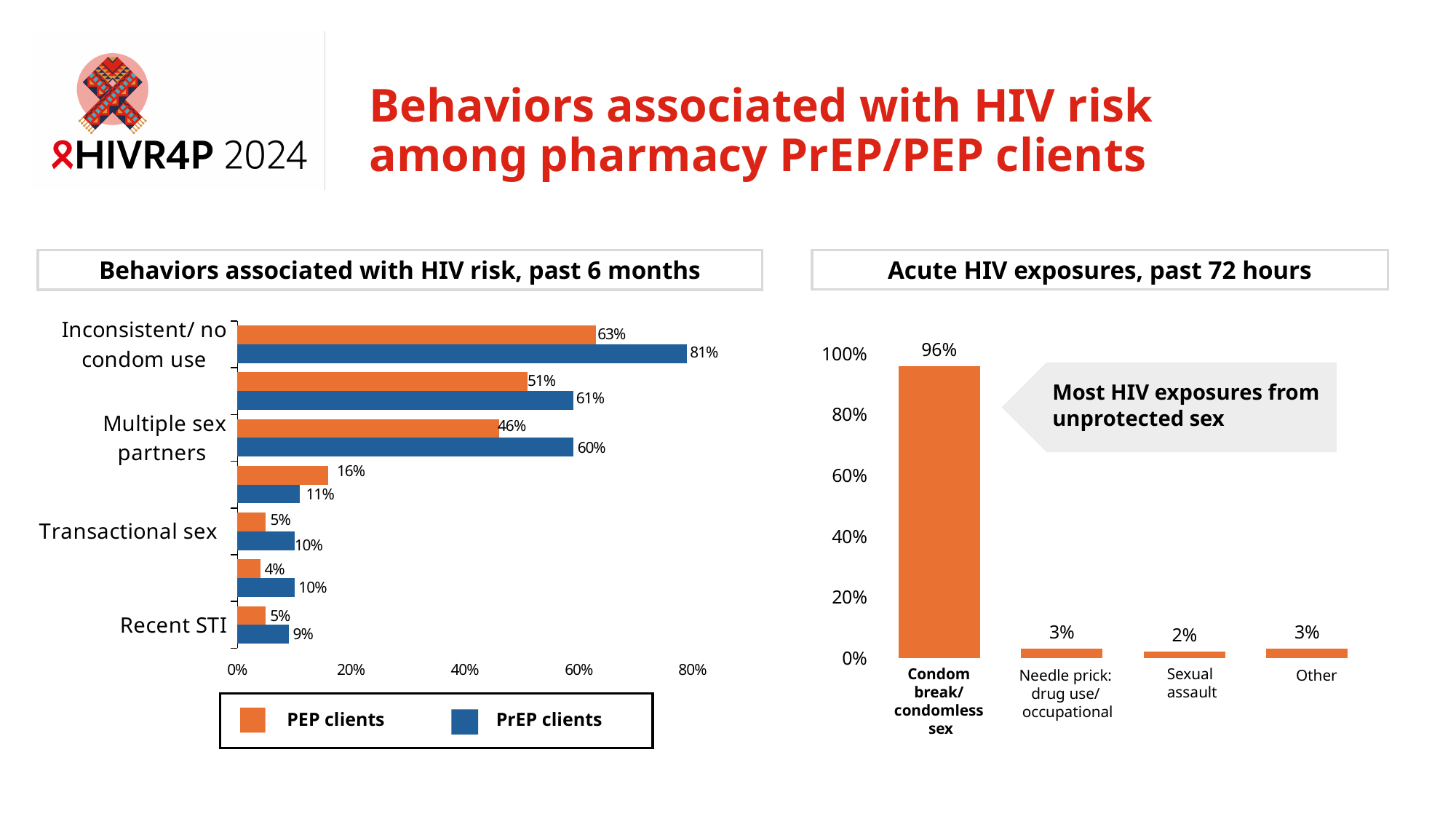
In the 'Behaviors associated with HIV risk, past 6 months' chart, what is the difference between PrEP clients and PEP clients for inconsistent/no condom use? 18% What kind of chart is the 'Acute HIV exposures, past 72 hours' chart? Bar chart In the 'Acute HIV exposures, past 72 hours' chart, which category has the highest value? Condom break/condomless sex In the 'Behaviors associated with HIV risk, past 6 months' chart, what percentage of PrEP clients reported inconsistent/no condom use? 81% In the 'Behaviors associated with HIV risk, past 6 months' chart, what percentage of PEP clients reported inconsistent/no condom use? 63% In the 'Behaviors associated with HIV risk, past 6 months' chart, which group has the higher value for transactional sex, PEP clients or PrEP clients? PrEP clients How many series does the legend of the 'Behaviors associated with HIV risk, past 6 months' chart list? 2 In the 'Behaviors associated with HIV risk, past 6 months' chart, what is the value for PEP clients for recent STI? 5% In the 'Acute HIV exposures, past 72 hours' chart, what is the difference between condom break/condomless sex and needle prick/drug use/occupational? 93% In the 'Behaviors associated with HIV risk, past 6 months' chart, what is the value for PrEP clients for multiple sex partners? 60% How many categories are shown in the 'Acute HIV exposures, past 72 hours' chart? 4 In the 'Acute HIV exposures, past 72 hours' chart, what is the value for sexual assault? 2%